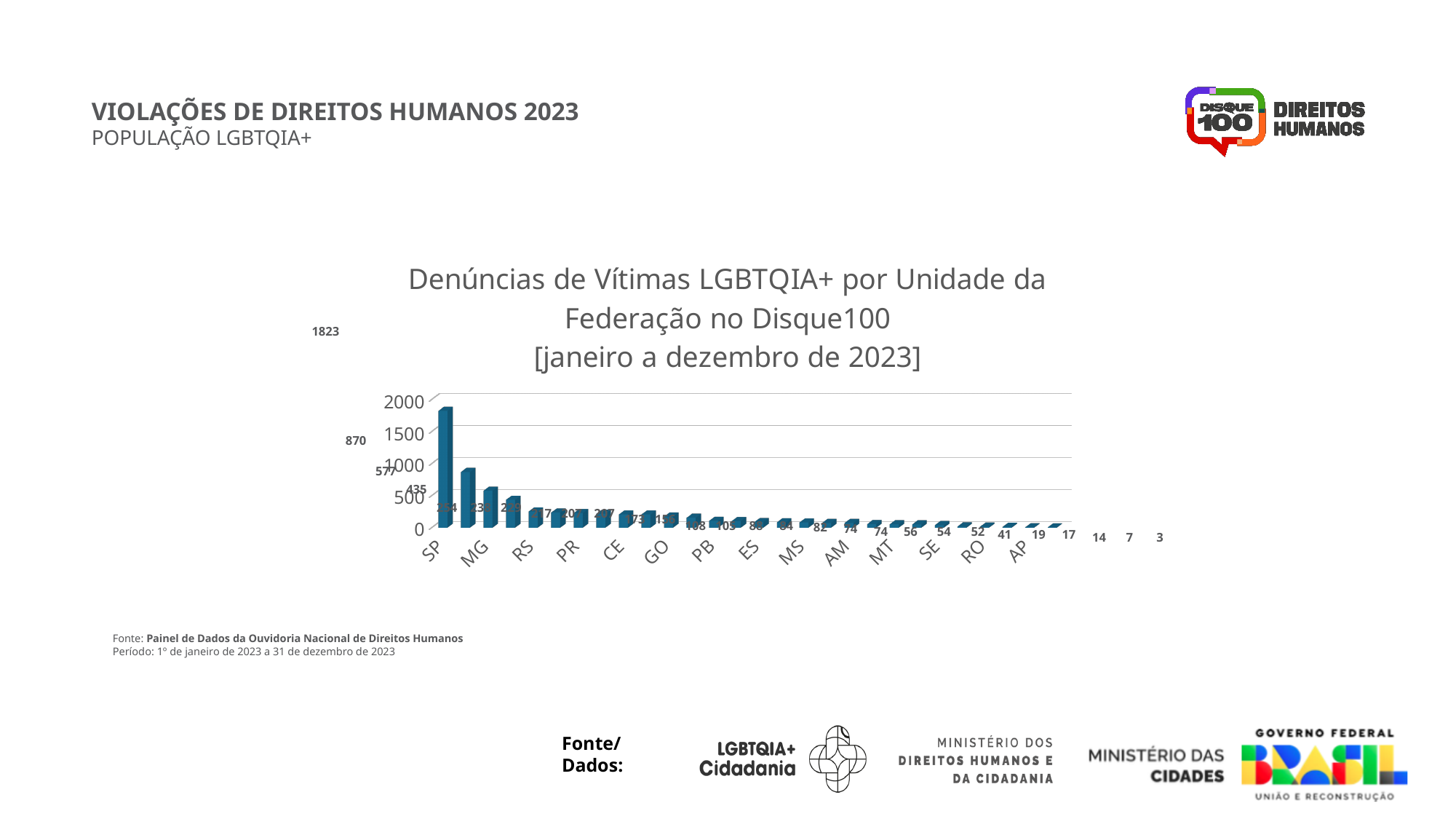
Which unit of the federation has the highest number of complaints? SP What is the difference between the values for SP and MG? 1246 What is the title of the chart? Denúncias de Vítimas LGBTQIA+ por Unidade da Federação no Disque100 [janeiro a dezembro de 2023] What kind of chart is shown on the slide? bar chart What is the value for SP? 1823 Is the value for MG greater or less than 1000? less What is the value for MG? 577 Which is larger, the value for SP or the value for MG? SP What is the smallest data label shown on the chart? 3 Do the values rise or fall from left to right along the x axis? fall What is the value for RS? 254 Is the value for SP greater or less than 1500? greater